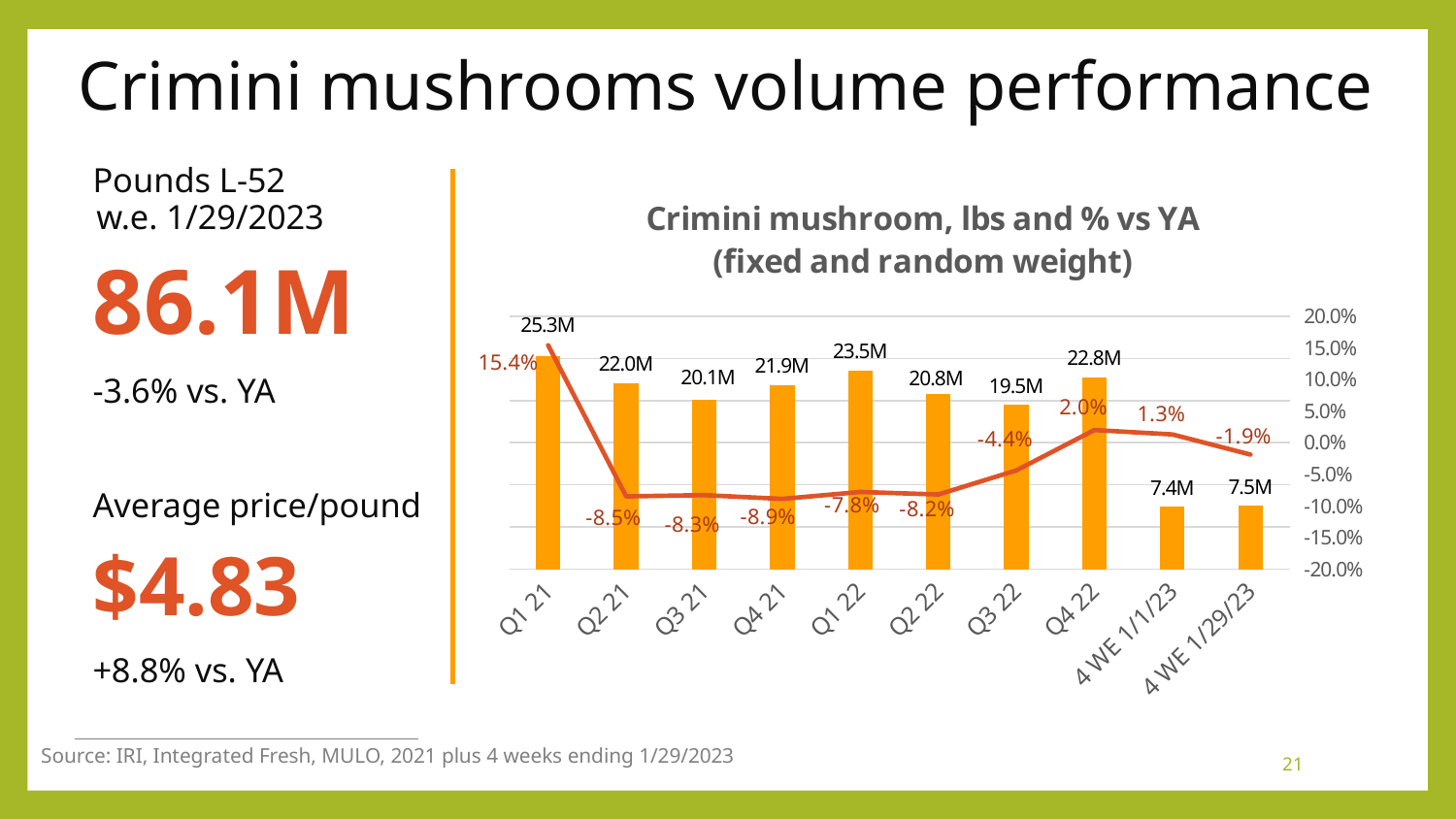
What is the % vs YA value for Q1 21? 15.4% What is the lbs value for Q1 21? 25.3M Which period has the lowest % vs YA value? Q4 21 Which period has the highest lbs bar? Q1 21 What is the difference in lbs between Q1 22 and Q2 22? 2.7M Does the % vs YA line rise or fall from Q3 22 to Q4 22? Rise What is the % vs YA value for Q3 22? -4.4% What is the lbs value for 4 WE 1/29/23? 7.5M What kind of chart is this? Combined bar and line chart What is the title of the chart? Crimini mushroom, lbs and % vs YA (fixed and random weight) How many periods are shown on the x axis? 10 Which is larger, the lbs value for Q4 22 or for Q2 21? Q4 22